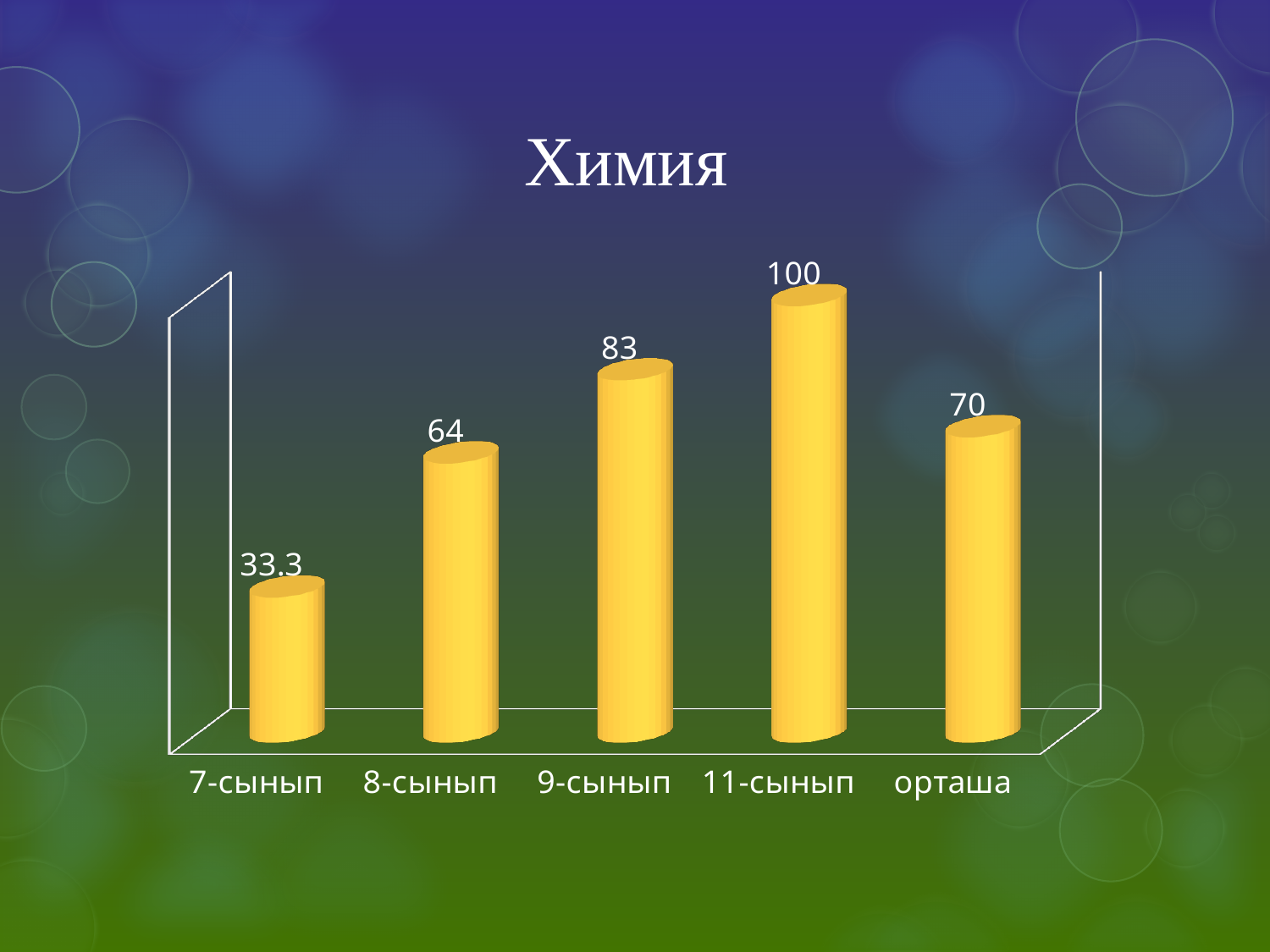
What is the value for 9-сынып? 83 What kind of chart is shown on the slide? bar chart How many categories are shown on the x axis? 5 Do the values rise or fall from 7-сынып to 11-сынып? rise Which is larger, the value for 8-сынып or the value for орташа? орташа Which category has the highest value? 11-сынып What is the title of the slide? Химия What is the difference between the values for 11-сынып and 8-сынып? 36 What is the difference between the values for 9-сынып and орташа? 13 What is the value for 7-сынып? 33.3 What is the value for орташа? 70 Which category has the lowest value? 7-сынып